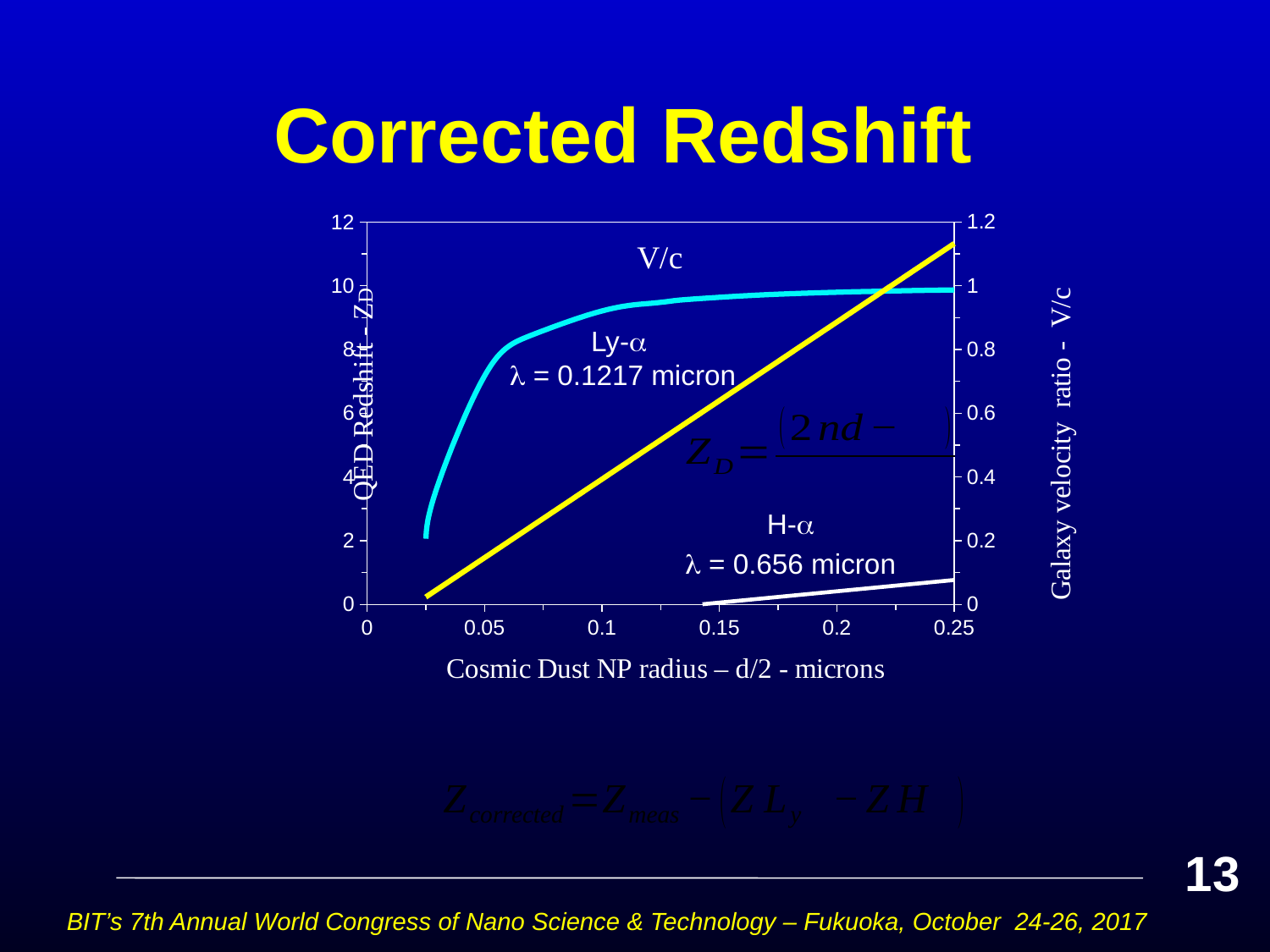
Is the Ly-α curve value at a radius of 0.25 microns greater or less than 8 on the left axis? greater How many curves are plotted on the chart? 3 What wavelength is given for the Ly-α curve on the chart? λ = 0.1217 micron Is the V/c curve value at a radius of 0.15 microns greater or less than 0.6 on the right axis? greater Does the H-α curve rise or fall as the dust radius increases along the x axis? rise What is the title of the slide containing the chart? Corrected Redshift What is the label of the x axis of the chart? Cosmic Dust NP radius – d/2 - microns Does the V/c curve rise or fall as the dust radius increases along the x axis? rise What kind of chart is shown on the slide? line chart